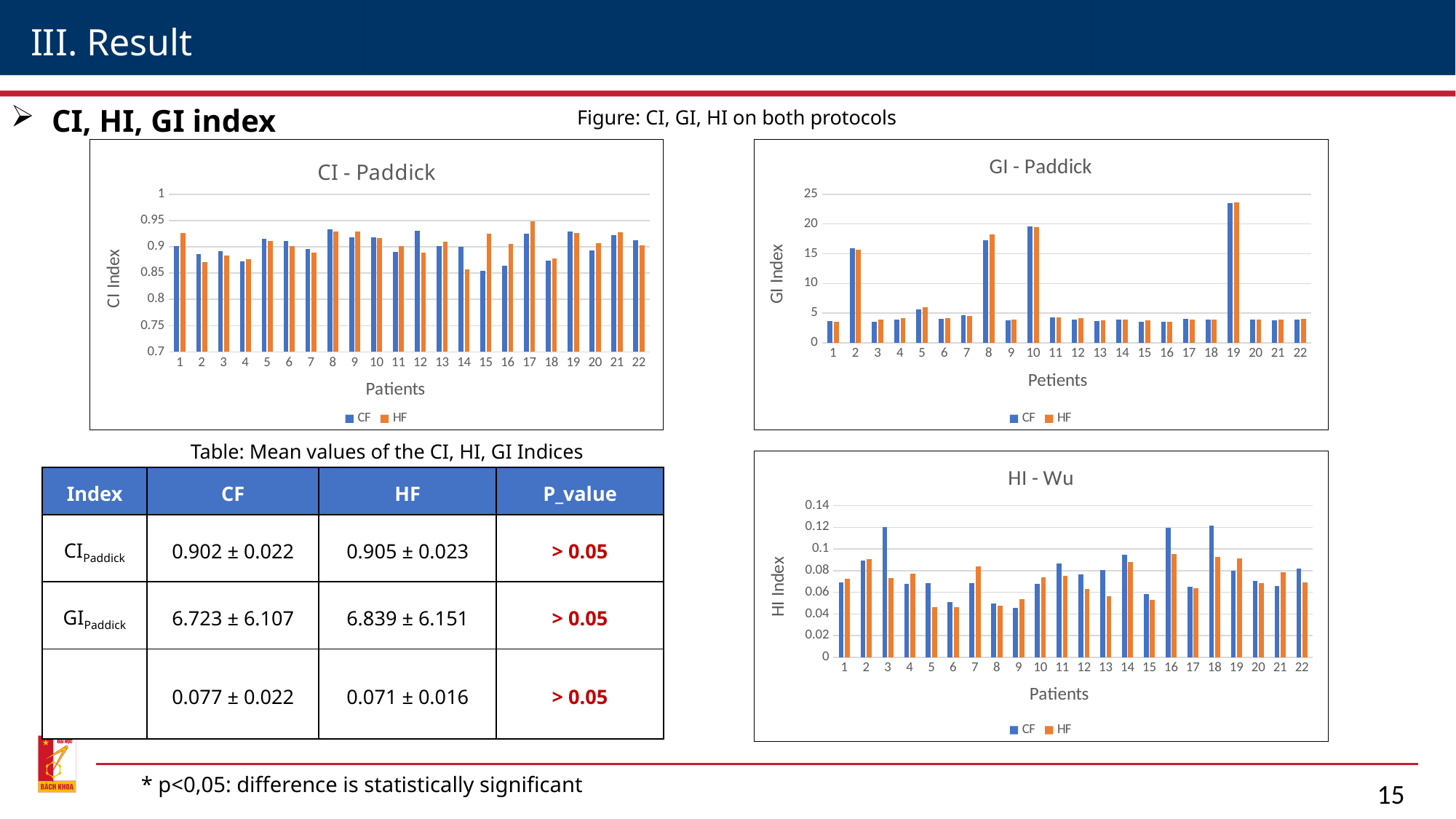
In the GI - Paddick chart, is the CF value for patient 1 greater or less than 5? less How many patients are shown on the x axis of the GI - Paddick chart? 22 In the HI - Wu chart, is the CF value for patient 3 greater or less than 0.1? greater In the GI - Paddick chart, is the CF value for patient 19 greater or less than 20? greater What are the two series named in the legend of the CI - Paddick chart? CF and HF In the GI - Paddick chart, which patient has the highest GI index? 19 How many series does the legend of the HI - Wu chart list? 2 In the HI - Wu chart, for patient 3, which series has the larger value, CF or HF? CF What kind of chart is the CI - Paddick chart? bar chart In the CI - Paddick chart, for patient 15, which series has the larger value, CF or HF? HF What is the x-axis title of the HI - Wu chart? Patients